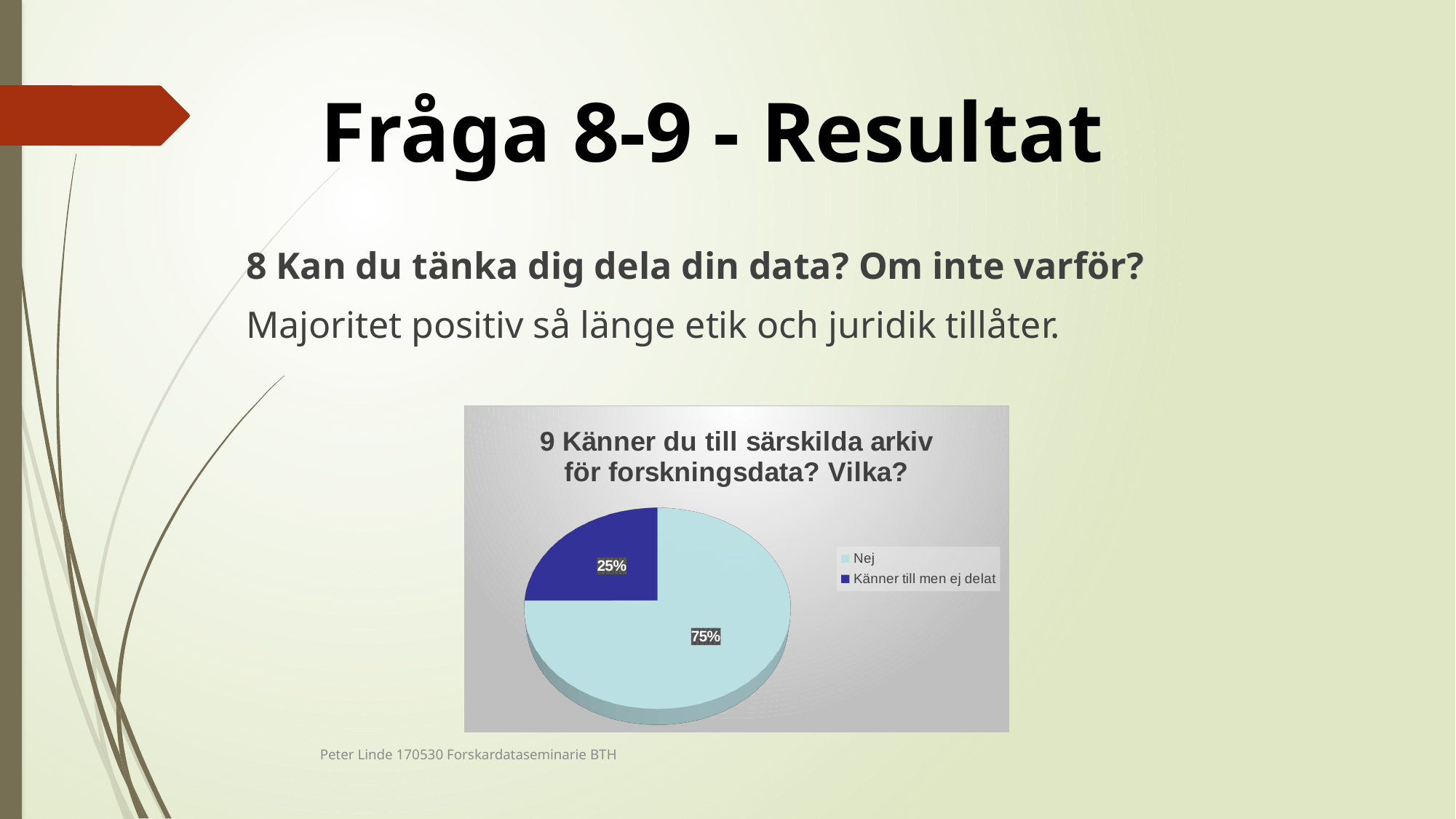
What share of the pie does "Nej" take? 75% How many slices does the pie chart have? 2 What share of the pie does "Känner till men ej delat" take? 25% What colour is the "Nej" slice in the pie chart? light blue What kind of chart is shown on the slide? pie chart What is the difference in percentage points between the "Nej" slice and the "Känner till men ej delat" slice? 50 What is the title of the pie chart? 9 Känner du till särskilda arkiv för forskningsdata? Vilka? Which is larger, the "Nej" slice or the "Känner till men ej delat" slice? Nej How many entries does the legend list? 2 Which slice of the pie is the largest? Nej Which slice of the pie is the smallest? Känner till men ej delat